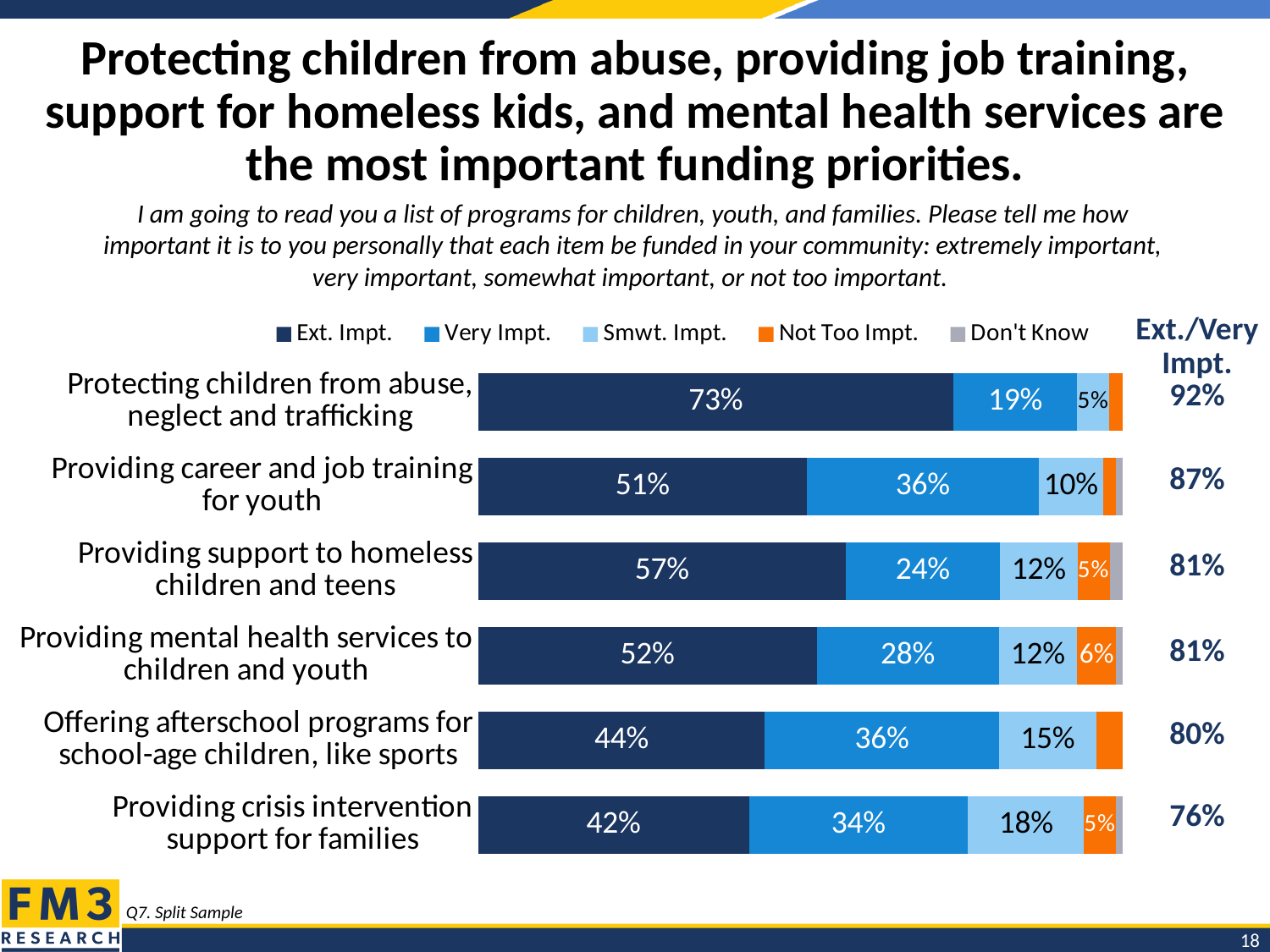
What is the combined Ext./Very Impt. figure for offering afterschool programs for school-age children, like sports? 80% What percentage rated protecting children from abuse, neglect and trafficking as extremely important (Ext. Impt.)? 73% What is the Smwt. Impt. value for providing crisis intervention support for families? 18% What is the difference in Ext. Impt. percentage between providing support to homeless children and teens and providing mental health services to children and youth? 5 percentage points What colour represents the Not Too Impt. category in the legend? Orange What type of chart is shown on the slide? Stacked bar chart What is the Very Impt. value for providing career and job training for youth? 36% Which program has the lowest Ext. Impt. percentage? Providing crisis intervention support for families How many programs are listed in the chart? 6 How many response categories does the legend list? 5 Which has a larger Very Impt. share: offering afterschool programs or providing crisis intervention support for families? Offering afterschool programs for school-age children, like sports Which program has the highest Ext. Impt. percentage? Protecting children from abuse, neglect and trafficking